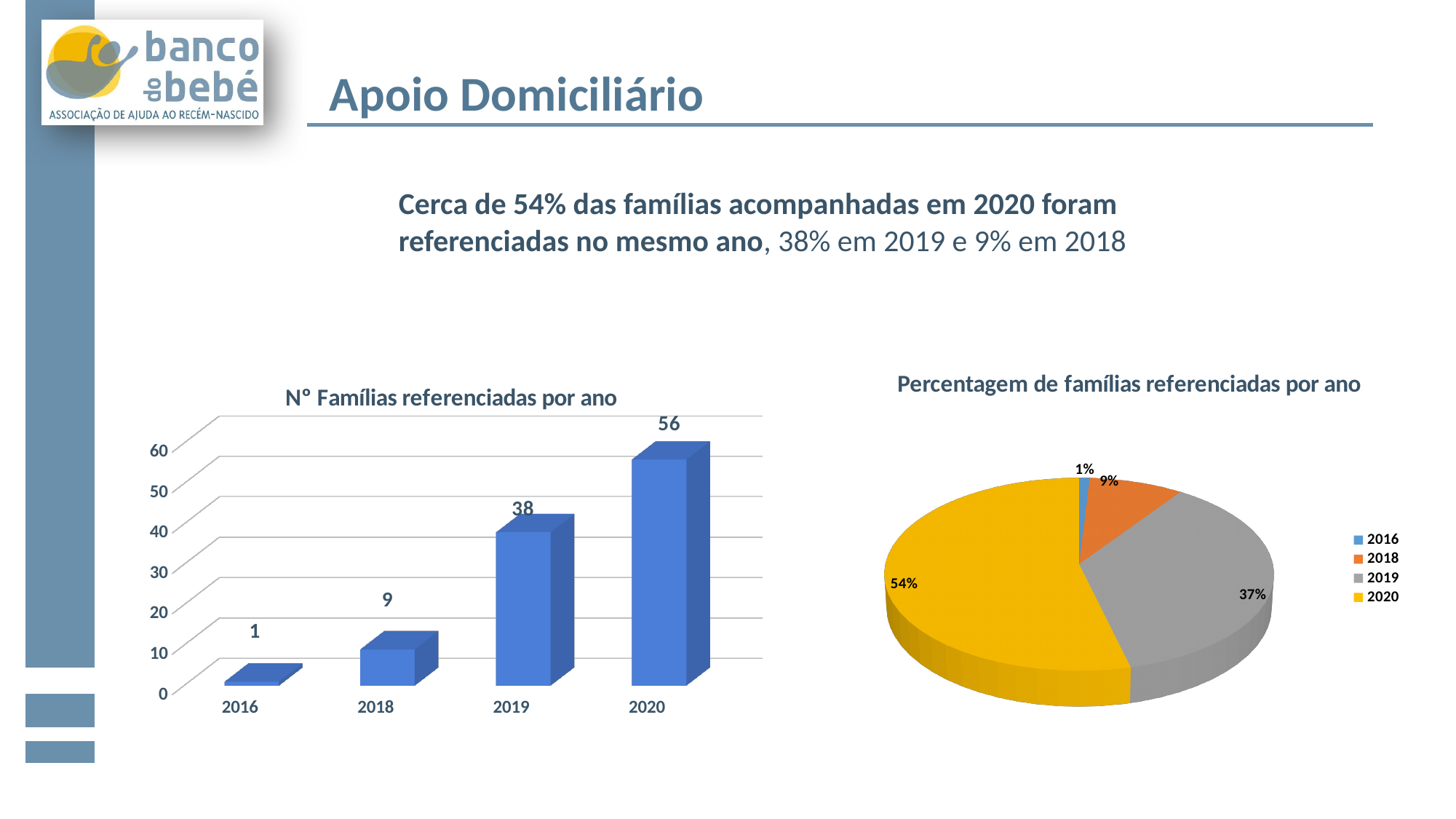
In the 'Percentagem de famílias referenciadas por ano' chart, what share does 2019 have? 37% In the 'Percentagem de famílias referenciadas por ano' chart, how many entries does the legend list? 4 In the 'Nº Famílias referenciadas por ano' chart, what is the value for 2016? 1 In the 'Nº Famílias referenciadas por ano' chart, do the values rise or fall from 2016 to 2020? rise In the 'Percentagem de famílias referenciadas por ano' chart, which colour represents 2020? yellow In the 'Nº Famílias referenciadas por ano' chart, how many years are shown on the x axis? 4 What kind of chart is 'Nº Famílias referenciadas por ano'? bar chart In the 'Nº Famílias referenciadas por ano' chart, which year has the highest value? 2020 In the 'Nº Famílias referenciadas por ano' chart, which year has the lowest value? 2016 In the 'Nº Famílias referenciadas por ano' chart, what is the difference between the values for 2020 and 2019? 18 In the 'Nº Famílias referenciadas por ano' chart, what is the value for 2019? 38 In the 'Percentagem de famílias referenciadas por ano' chart, what share does 2018 have? 9%